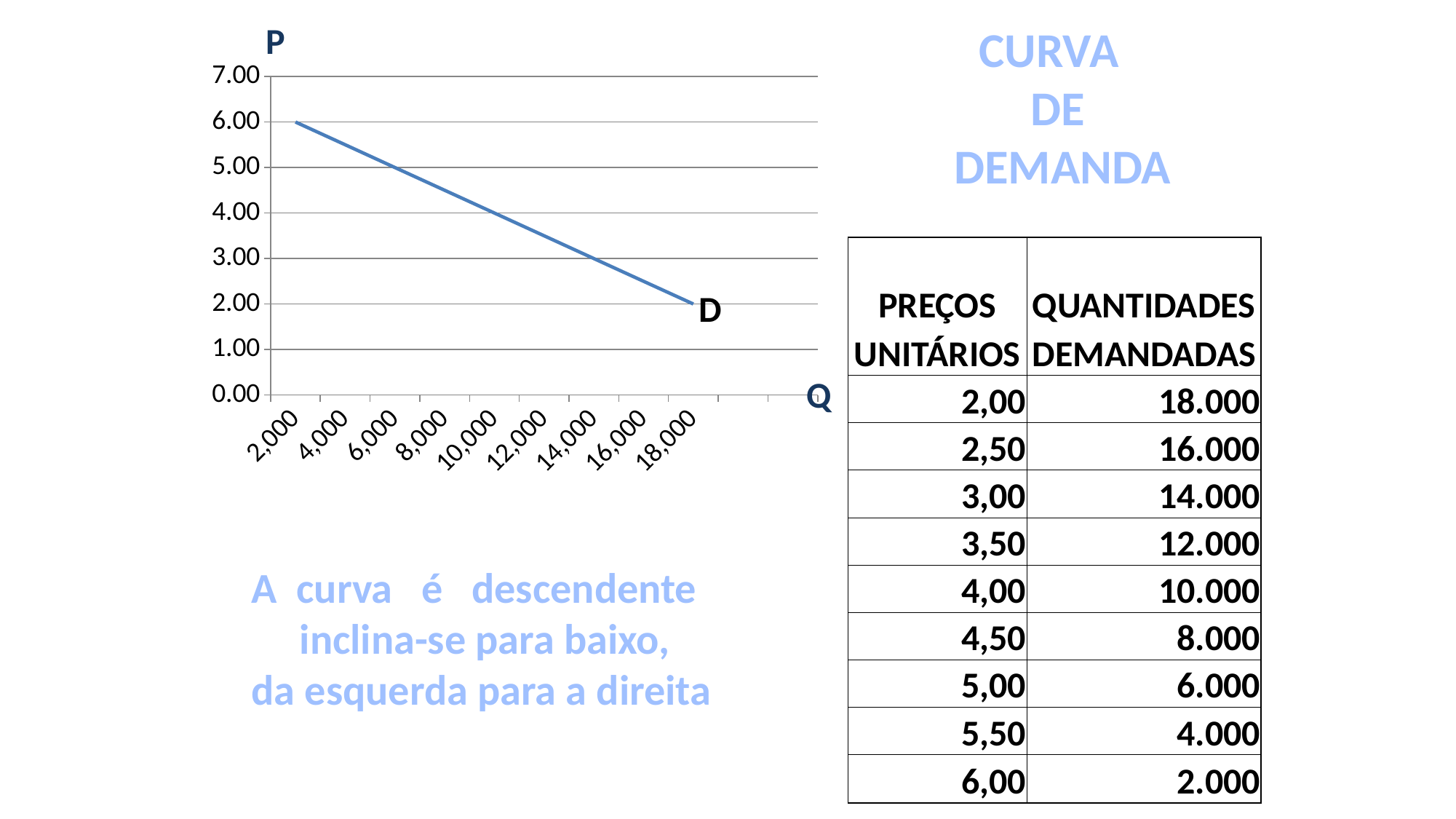
Do the values on the demand curve rise or fall as Q increases along the x axis? fall What is the value of P on the demand curve at Q = 2,000? 6.00 Is the value of P at Q = 4,000 greater or less than 6.00? less What kind of chart is shown on the slide? line chart How many Q values are labelled on the x axis of the chart? 9 Is the value of P at Q = 14,000 greater or less than 4.00? less What is the value of P on the demand curve at Q = 10,000? 4.00 What letters label the vertical and horizontal axes of the chart? P and Q What is the value of P on the demand curve at Q = 18,000? 2.00 What letter labels the line plotted on the chart? D Is the value of P at Q = 6,000 greater or less than 4.00? greater Which Q value has the highest P on the demand curve, 2,000 or 18,000? 2,000